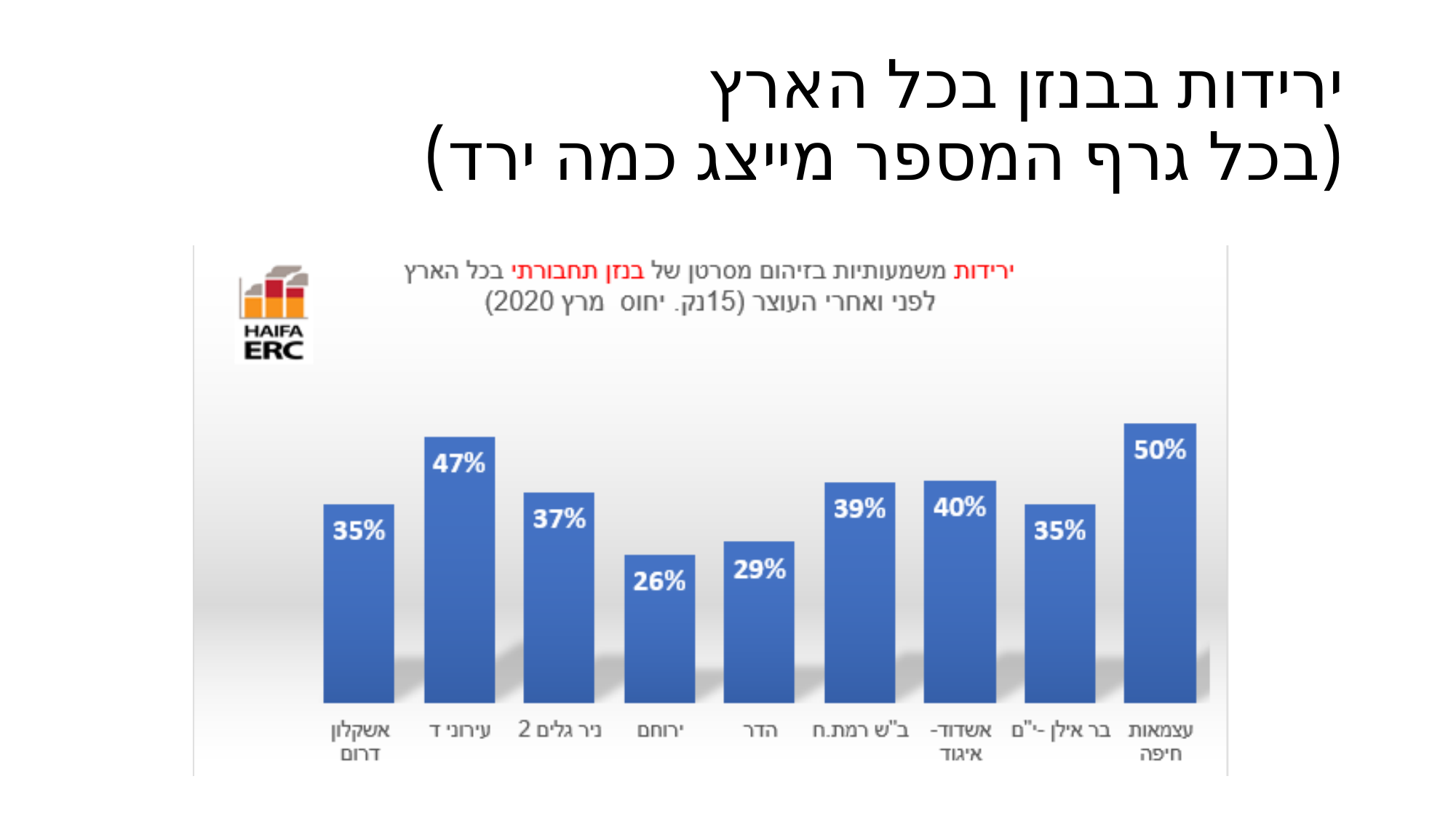
Which category has the highest value? עצמאות חיפה How many categories are shown in the chart? 9 What is the value shown for אשדוד-איגוד? 40% What kind of chart is shown on the slide? Bar chart What is the value shown for ירוחם? 26% Which category has the lowest value? ירוחם Which is larger, the value for הדר or the value for ב"ש רמת.ח? ב"ש רמת.ח What is the value shown for עצמאות חיפה? 50% What is the value shown for עירוני ד? 47% What is the difference between the values for עירוני ד and ניר גלים 2? 10% What is the difference between the values for עצמאות חיפה and ירוחם? 24% What colour are the bars in the chart? Blue